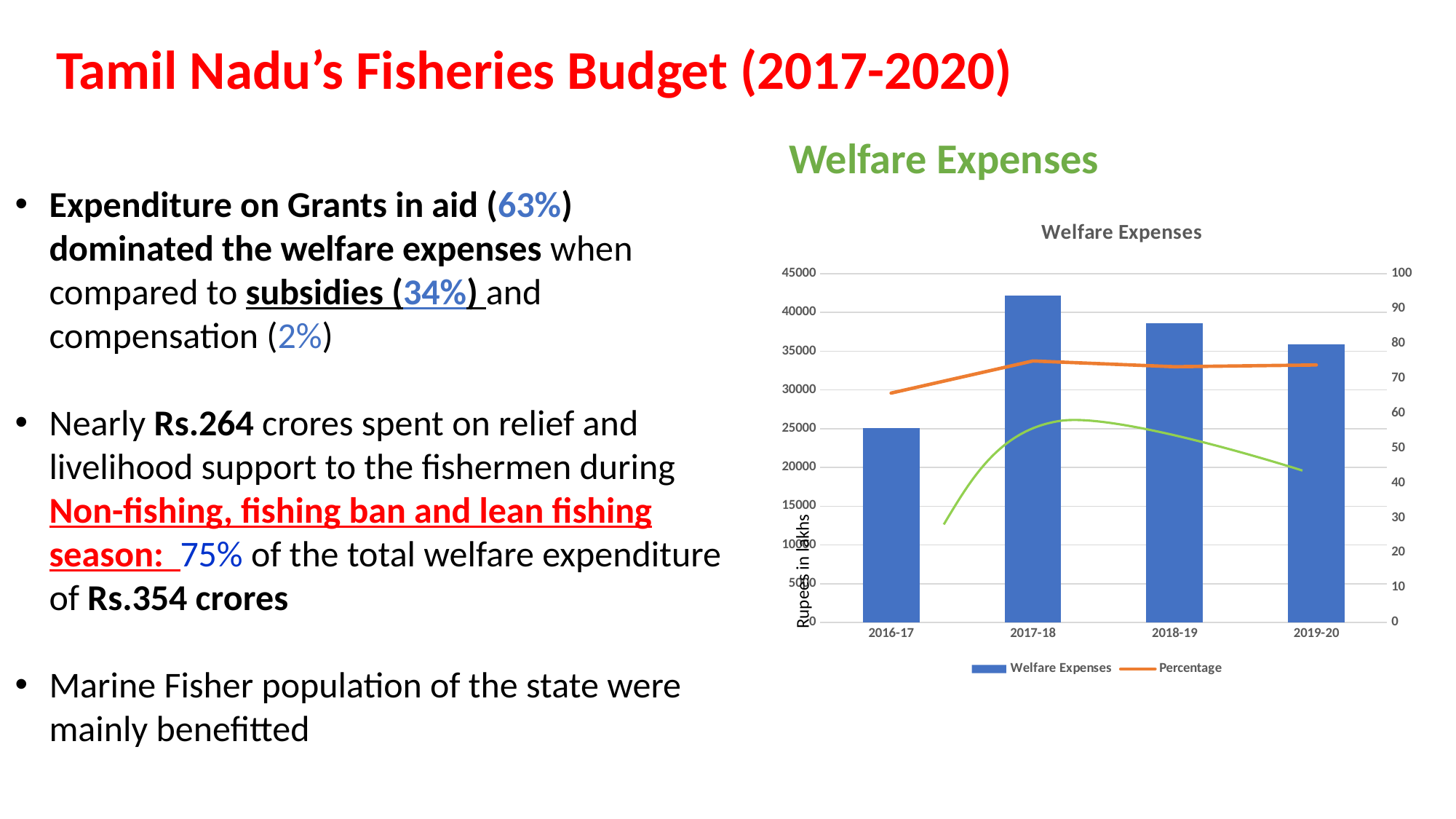
How many years are shown on the x axis of the Welfare Expenses chart? 4 How many series does the legend of the Welfare Expenses chart list? 2 Which is larger, the Welfare Expenses bar for 2018-19 or for 2019-20? 2018-19 Which year has the lowest Welfare Expenses bar? 2016-17 Is the Welfare Expenses bar for 2018-19 greater or less than 35000? greater Is the Welfare Expenses bar for 2017-18 greater or less than 40000? greater What kind of chart is shown under the title "Welfare Expenses"? bar chart (with a line series) Is the Welfare Expenses bar for 2019-20 greater or less than 40000? less What is the label on the left vertical axis of the Welfare Expenses chart? Rupees in lakhs Which year has the highest Welfare Expenses bar? 2017-18 Do the Welfare Expenses bars rise or fall from 2017-18 to 2019-20? fall